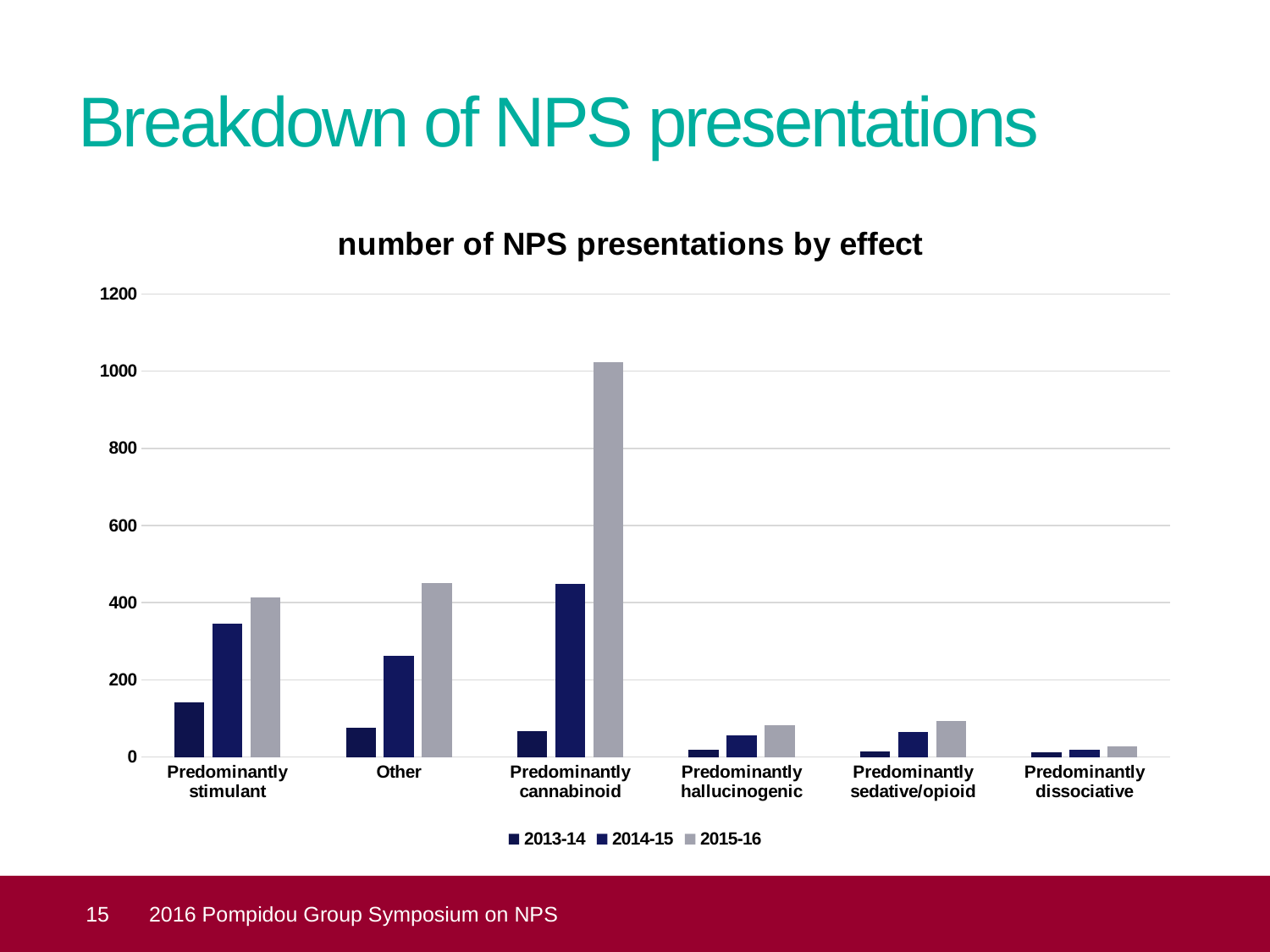
Which is larger for 2014-15: Predominantly stimulant or Other? Predominantly stimulant How many effect categories are shown on the x axis? 6 Is the 2013-14 value for Predominantly stimulant greater or less than 200? less What kind of chart is shown on the slide? Bar chart What are the three series listed in the legend? 2013-14, 2014-15, 2015-16 Is the 2015-16 value for Predominantly cannabinoid greater or less than 800? greater Is the 2015-16 value for Other greater or less than 400? greater How many series does the legend list? 3 Which category has the lowest value for 2015-16? Predominantly dissociative Which category has the highest value for 2015-16? Predominantly cannabinoid For Predominantly cannabinoid, do the values rise or fall from 2013-14 to 2015-16? rise What is the title of the chart? number of NPS presentations by effect